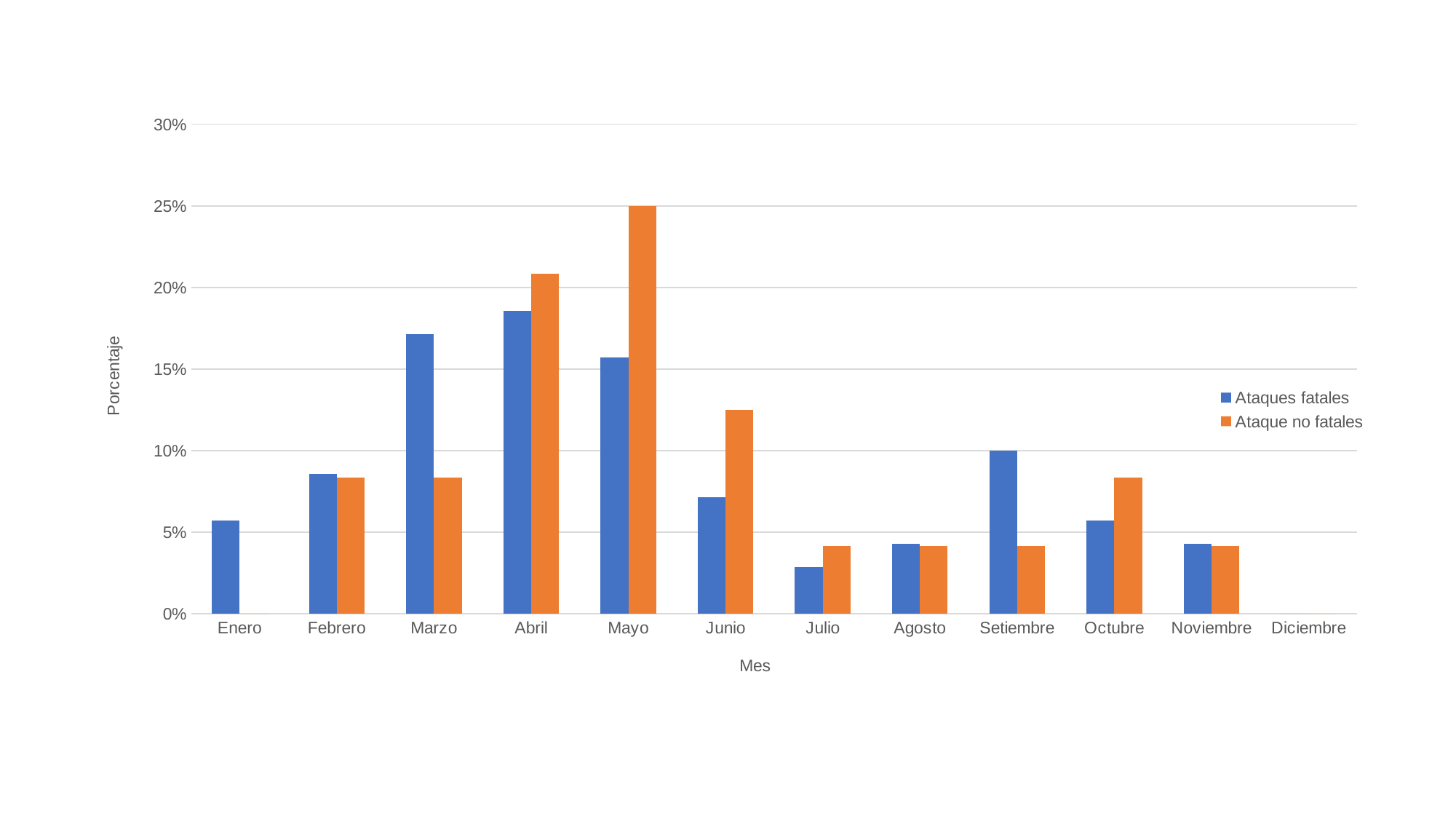
What is the value for Ataques fatales in Setiembre? 10% How many months are shown on the x axis? 12 What is the label of the y axis? Porcentaje Which month has the highest value for Ataques fatales? Abril Is the value for Ataques fatales in Marzo greater or less than 15%? greater What is the value for Ataque no fatales in Mayo? 25% In Setiembre, which series has the larger value, Ataques fatales or Ataque no fatales? Ataques fatales What kind of chart is shown on the slide? bar chart Which month has the highest value for Ataque no fatales? Mayo In Abril, which series has the larger value, Ataques fatales or Ataque no fatales? Ataque no fatales Is the value for Ataque no fatales in Junio greater or less than 15%? less How many series does the legend list? 2